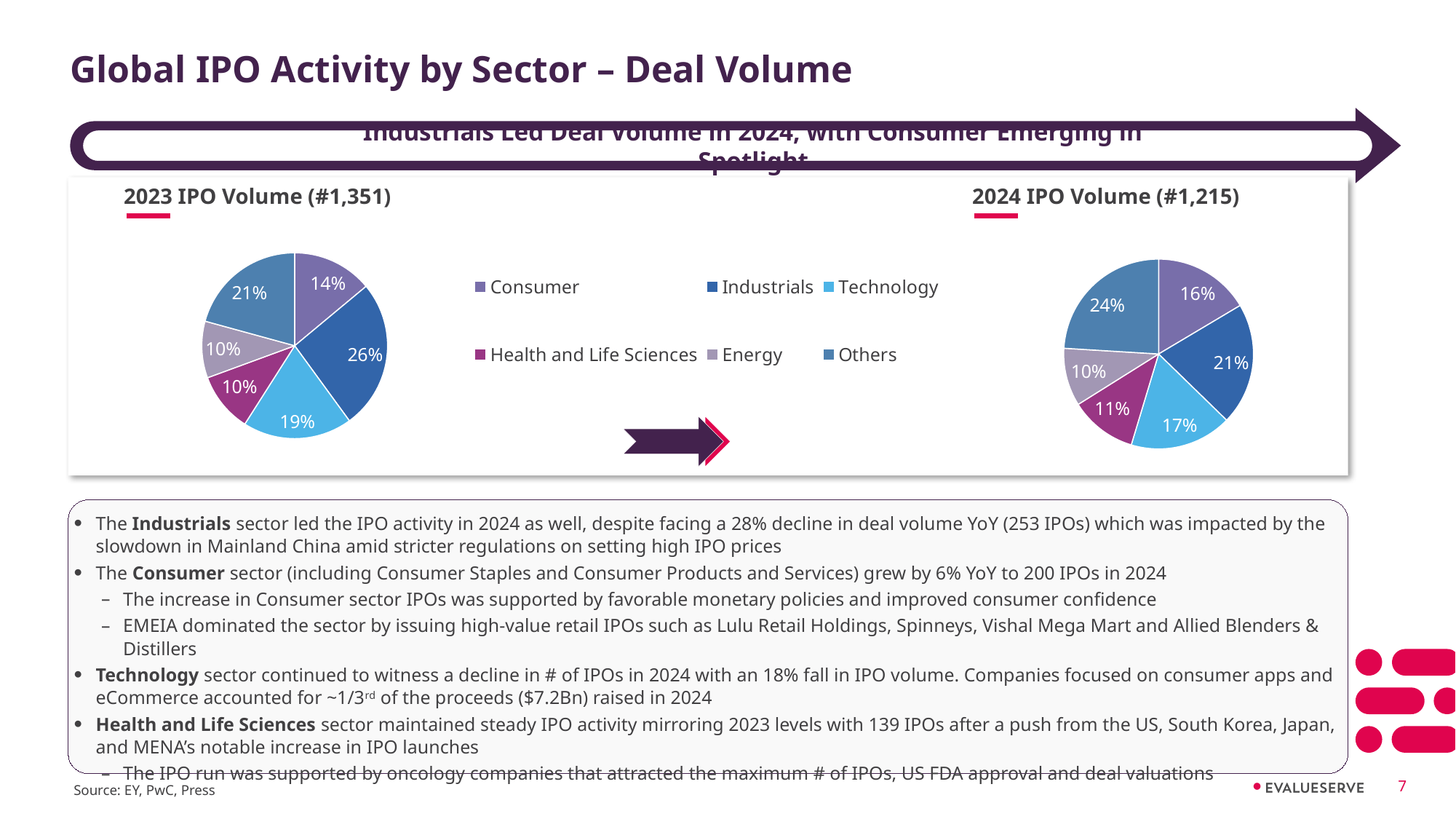
In the 2024 IPO Volume pie chart, which is larger: the Technology share or the Health and Life Sciences share? Technology In the 2023 IPO Volume pie chart, what share does Industrials have? 26% In the 2023 IPO Volume pie chart, which sector has the largest share? Industrials How many sectors does the legend list for the pie charts? 6 In the 2024 IPO Volume pie chart, what share does Technology have? 17% In the 2023 IPO Volume pie chart, what share does Others have? 21% What total number of IPOs is shown in the title of the 2024 IPO Volume chart? #1,215 In the 2024 IPO Volume pie chart, which sector has the largest share? Others In the 2024 IPO Volume pie chart, what share does Consumer have? 16% What is the difference in percentage points between the Industrials share in the 2023 pie chart and the Industrials share in the 2024 pie chart? 5 percentage points What type of chart is used to show the 2023 and 2024 IPO volume by sector? Pie chart In the 2024 IPO Volume pie chart, which sector has the smallest share? Energy